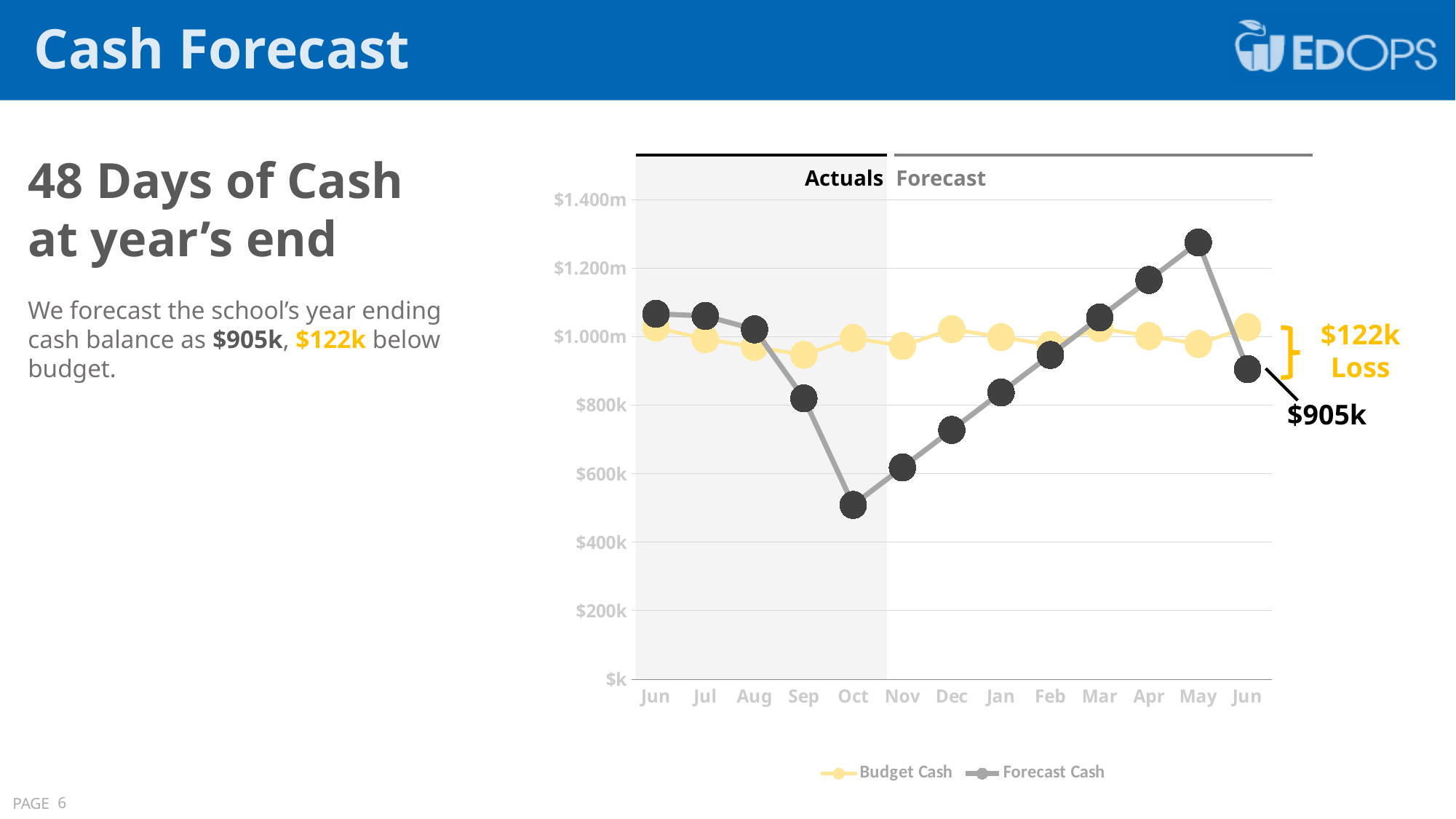
Does Forecast Cash rise or fall from Oct to May? rises What is the Forecast Cash value for the final Jun on the chart? $905k How many months are plotted along the x axis of the chart? 13 In Oct, which series has the larger value, Budget Cash or Forecast Cash? Budget Cash In which month is Forecast Cash at its lowest? Oct Is the Forecast Cash value for Oct greater or less than $600k? less Is the Forecast Cash value for May greater or less than $1.200m? greater What kind of chart is shown on the slide? line chart How many series does the chart legend list? 2 Is the Forecast Cash value for Dec greater or less than $800k? less In which month is Forecast Cash at its highest? May By how much is the year-end Forecast Cash below Budget Cash, according to the chart annotation? $122k